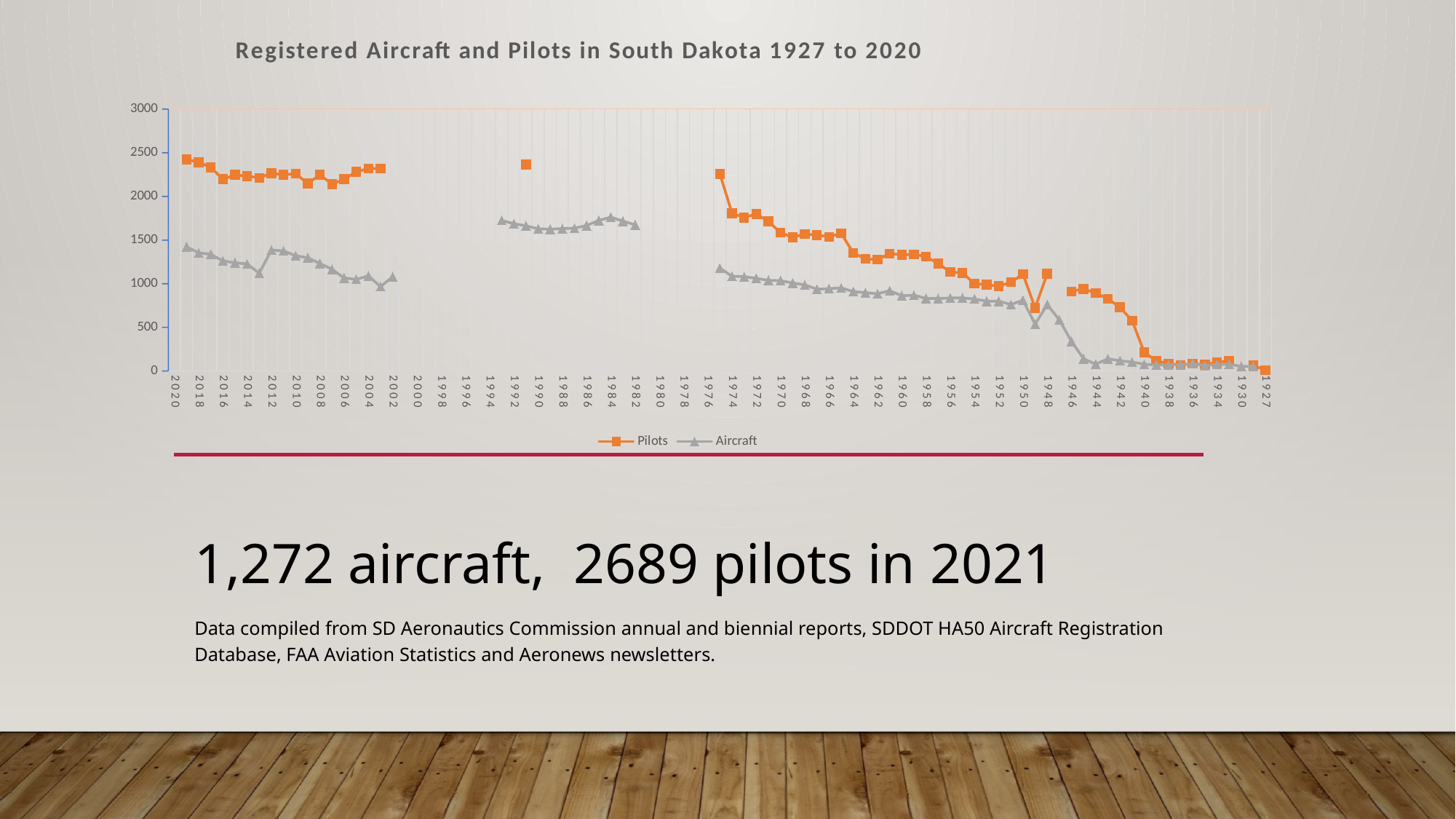
Which colour is used for the Pilots series? Orange Is the value for Aircraft in 1984 greater or less than 1500? greater What kind of chart is shown on the slide? Line chart Is the value for Pilots in 1927 greater or less than 500? less What is the title of the chart? Registered Aircraft and Pilots in South Dakota 1927 to 2020 How many series does the legend list? 2 Reading the Pilots series from 1976 to 1927, do the values generally rise or fall? fall